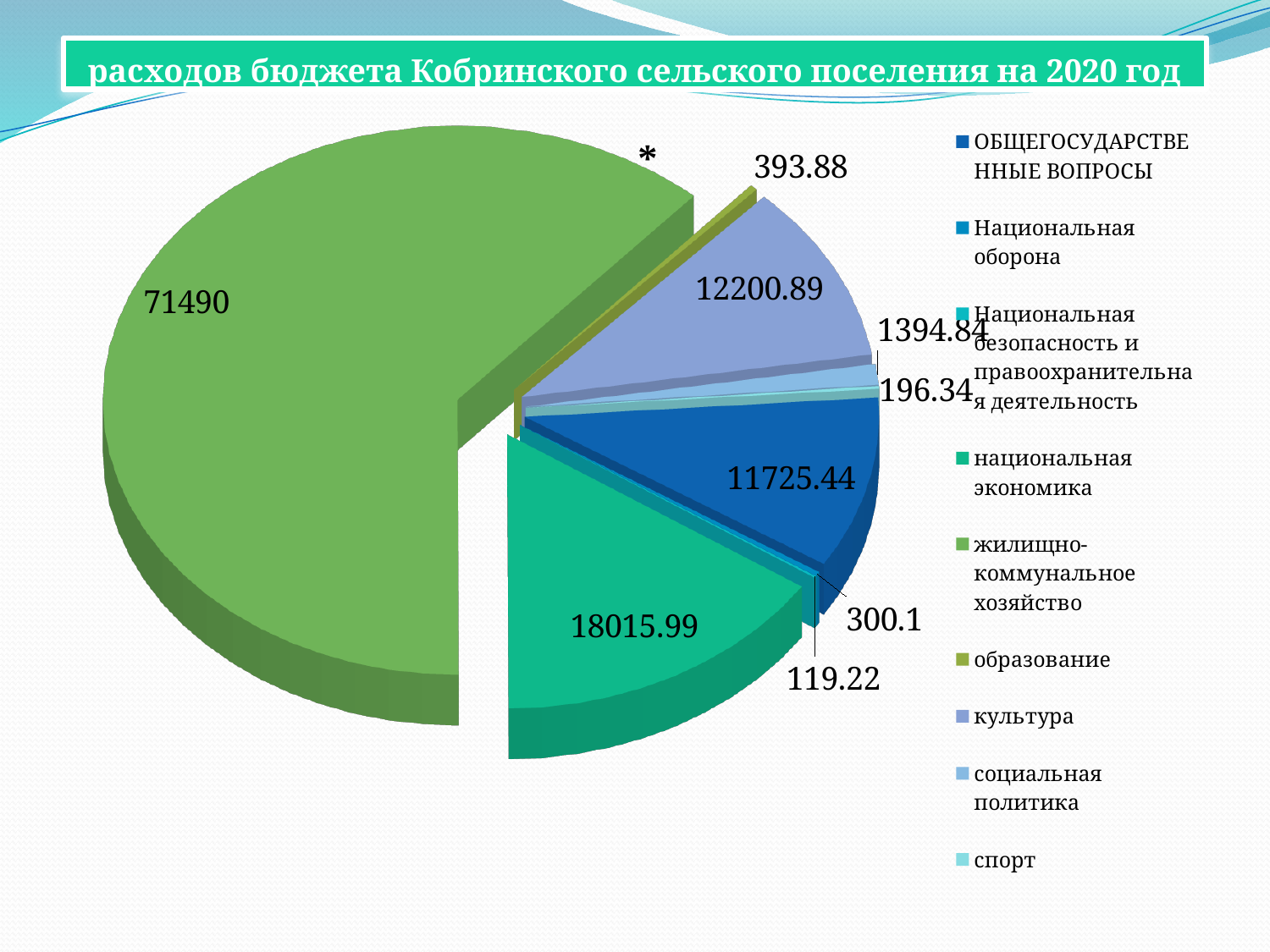
What is the difference between the values for национальная экономика and ОБЩЕГОСУДАРСТВЕННЫЕ ВОПРОСЫ? 6290.55 Which category has the smallest value? Национальная безопасность и правоохранительная деятельность What year does the slide title say the budget expenditures are for? 2020 What value is shown for культура? 12200.89 Which is larger, национальная экономика or ОБЩЕГОСУДАРСТВЕННЫЕ ВОПРОСЫ? национальная экономика What value is shown for национальная экономика? 18015.99 Which category has the largest slice of the pie? жилищно-коммунальное хозяйство What kind of chart is shown on the slide? pie chart What value is shown for образование? 393.88 What value is shown for ОБЩЕГОСУДАРСТВЕННЫЕ ВОПРОСЫ? 11725.44 How many categories does the legend list? 9 What value is shown for жилищно-коммунальное хозяйство? 71490